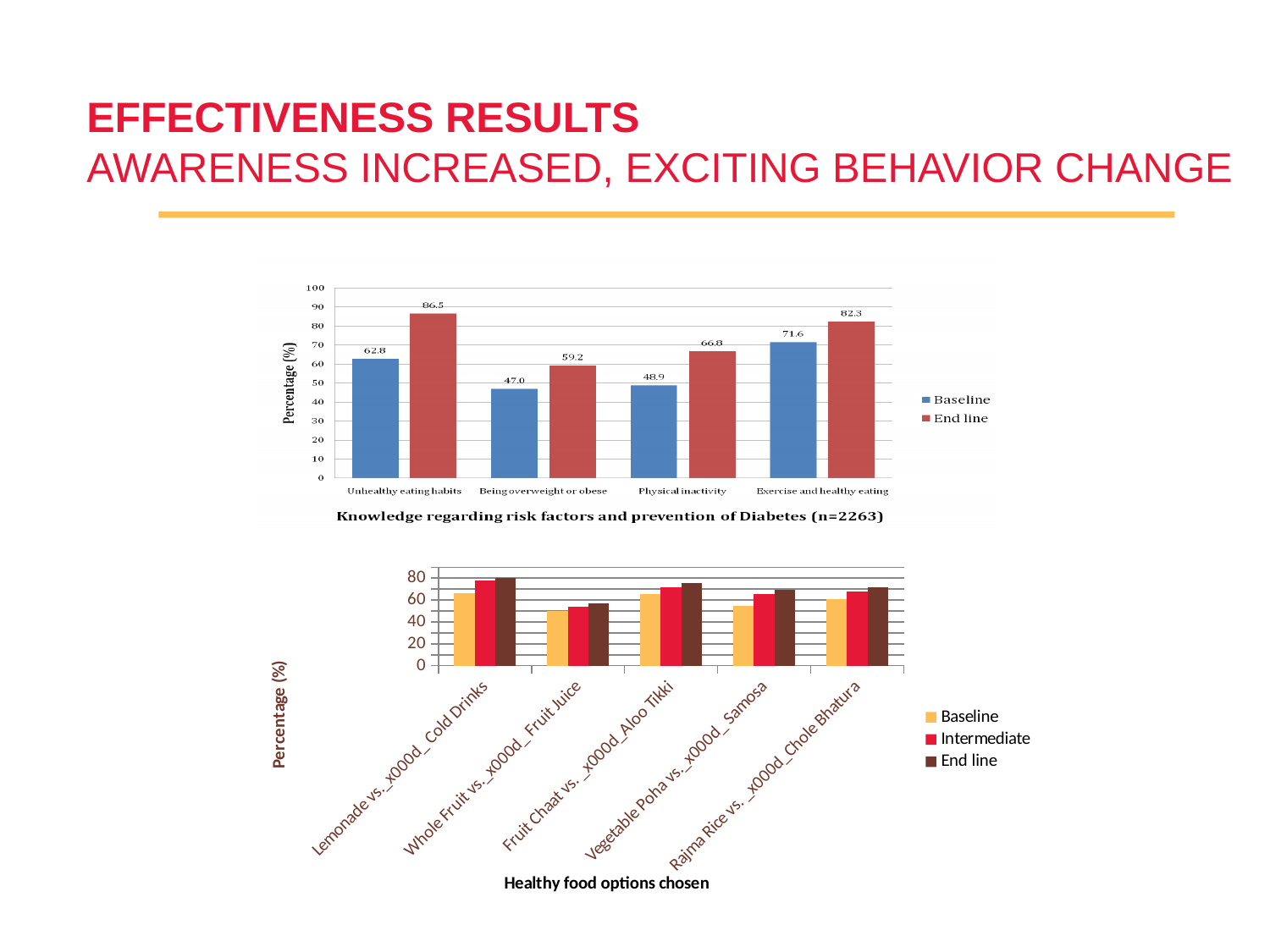
In the bottom chart (Healthy food options chosen), how many series does the legend list? 3 In the top chart (Knowledge regarding risk factors and prevention of Diabetes), what is the End line value for Unhealthy eating habits? 86.5 In the top chart (Knowledge regarding risk factors and prevention of Diabetes), what is the Baseline value for Physical inactivity? 48.9 In the bottom chart (Healthy food options chosen), what kind of chart is shown? Bar chart In the top chart (Knowledge regarding risk factors and prevention of Diabetes), how many categories are shown on the x axis? 4 In the top chart (Knowledge regarding risk factors and prevention of Diabetes), what sample size is given in the chart title? n=2263 In the bottom chart (Healthy food options chosen), is the Baseline value for Whole Fruit vs. Fruit Juice greater or less than 40? greater In the bottom chart (Healthy food options chosen), is the End line value for Lemonade vs. Cold Drinks greater or less than 60? greater In the top chart (Knowledge regarding risk factors and prevention of Diabetes), which is larger: the Baseline value for Unhealthy eating habits or the Baseline value for Exercise and healthy eating? Exercise and healthy eating In the top chart (Knowledge regarding risk factors and prevention of Diabetes), which category has the lowest Baseline value? Being overweight or obese In the top chart (Knowledge regarding risk factors and prevention of Diabetes), which category has the highest End line value? Unhealthy eating habits In the top chart (Knowledge regarding risk factors and prevention of Diabetes), what is the difference between the End line and Baseline values for Exercise and healthy eating? 10.7